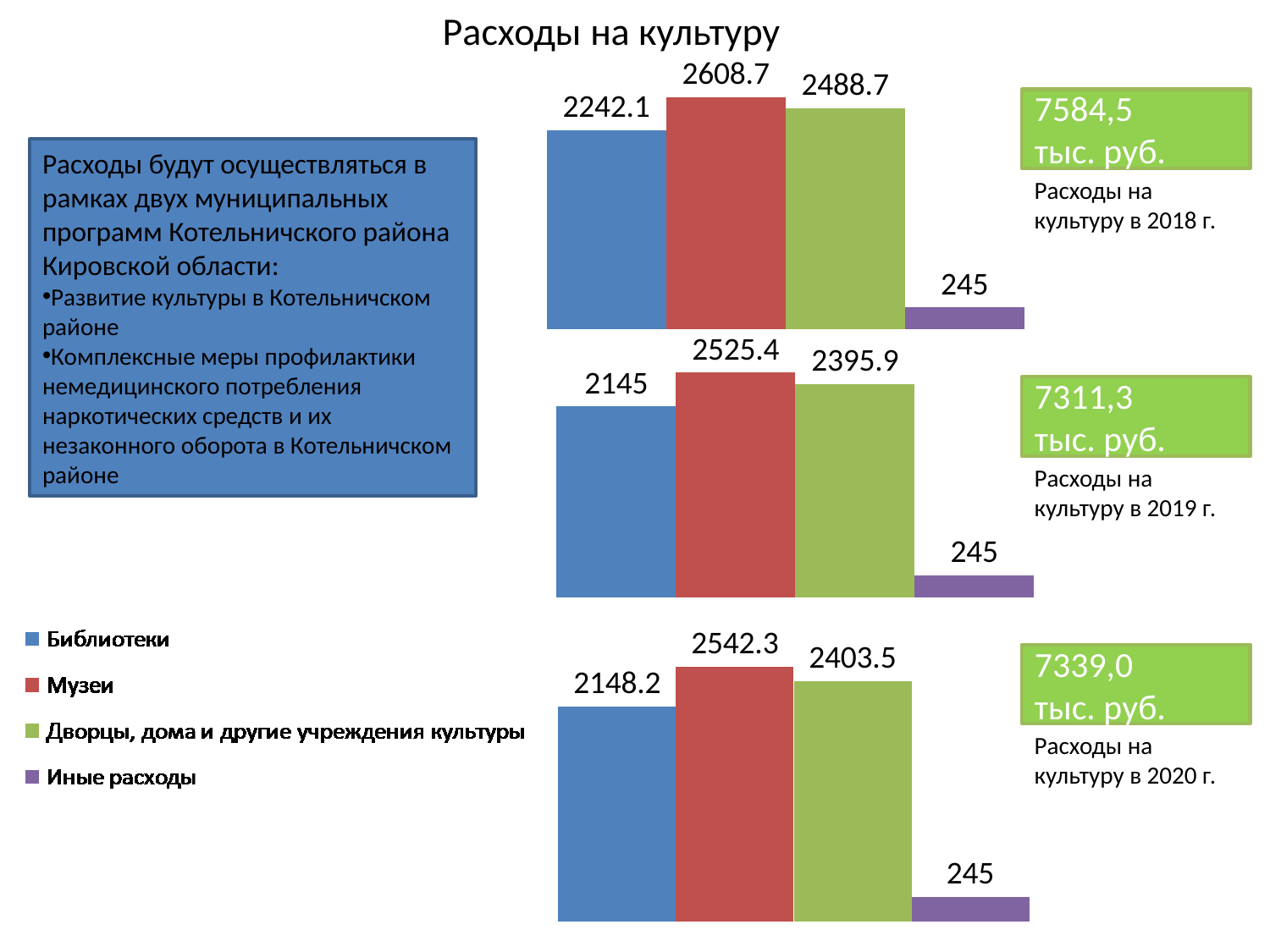
In the 2020 chart (bottom), which category has the lowest value? Иные расходы What kind of chart is used for the 2019 data (middle)? Bar chart In the 2020 chart (bottom), which is larger: the value for Музеи or the value for Библиотеки? Музеи In the 2019 chart (middle), what is the value for Библиотеки? 2145 What is the value for Иные расходы in the 2019 chart (middle)? 245 In the 2018 chart (top), what is the value for Музеи? 2608.7 In the 2020 chart (bottom), what is the value for Дворцы, дома и другие учреждения культуры? 2403.5 In the 2018 chart (top), which category has the highest value? Музеи How many bars are plotted in the 2018 chart (top)? 4 In the 2019 chart (middle), what is the difference between the values for Музеи and Библиотеки? 380.4 How many series does the legend list? 4 What colour represents Библиотеки in the legend? Blue